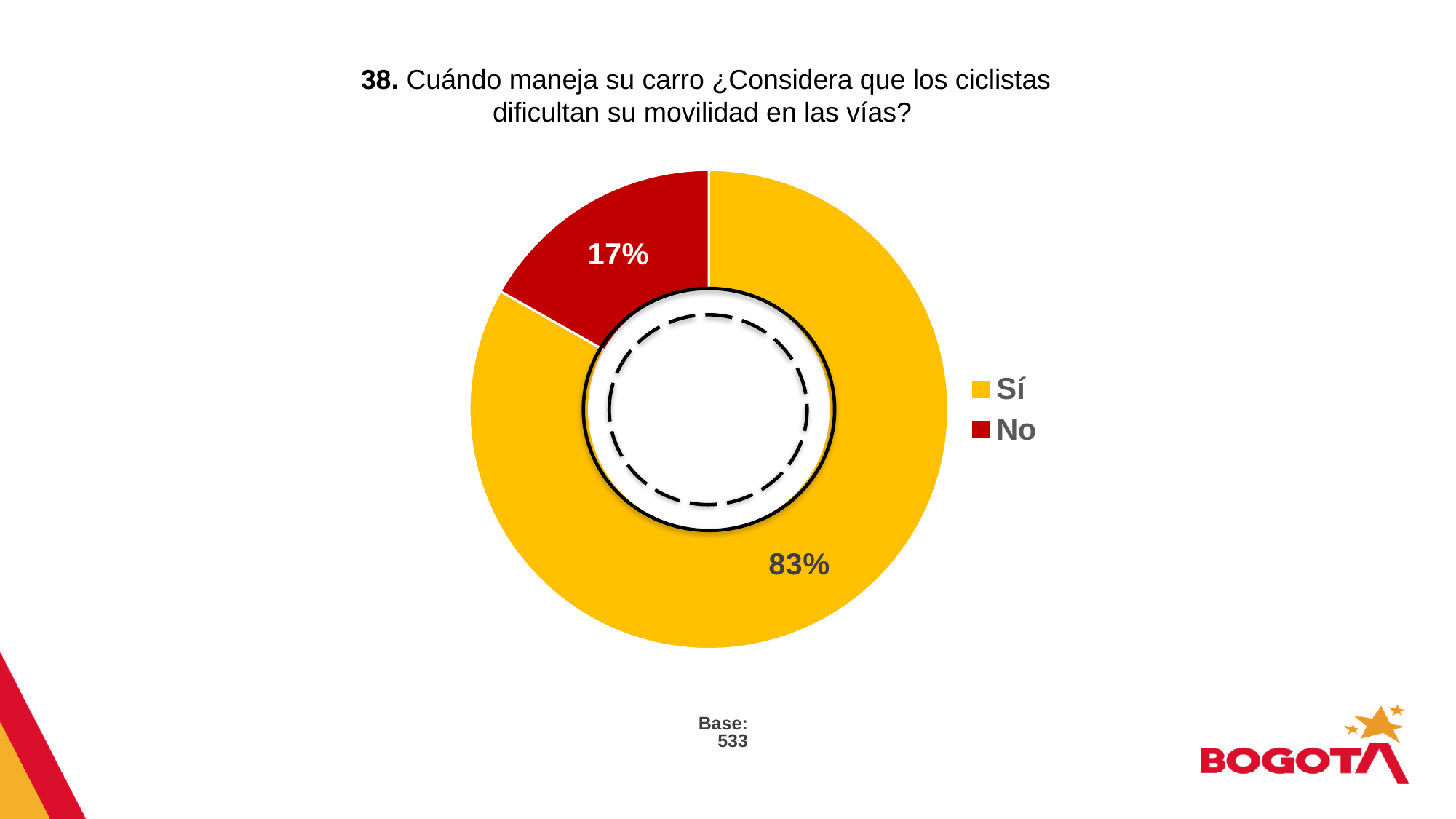
Which response has the largest share of the pie? Sí What kind of chart is shown on the slide? Doughnut chart What colour is the "Sí" slice? Yellow What is the difference in percentage points between the "Sí" and "No" shares? 66 Which response has the smallest share of the pie? No What percentage of respondents answered "Sí"? 83% How many entries does the legend list? 2 What is the base (number of respondents) shown below the chart? 533 What percentage of respondents answered "No"? 17% What share of the pie does the "No" slice represent? 17% Which is larger, the share for "Sí" or the share for "No"? Sí How many categories does the pie chart show? 2